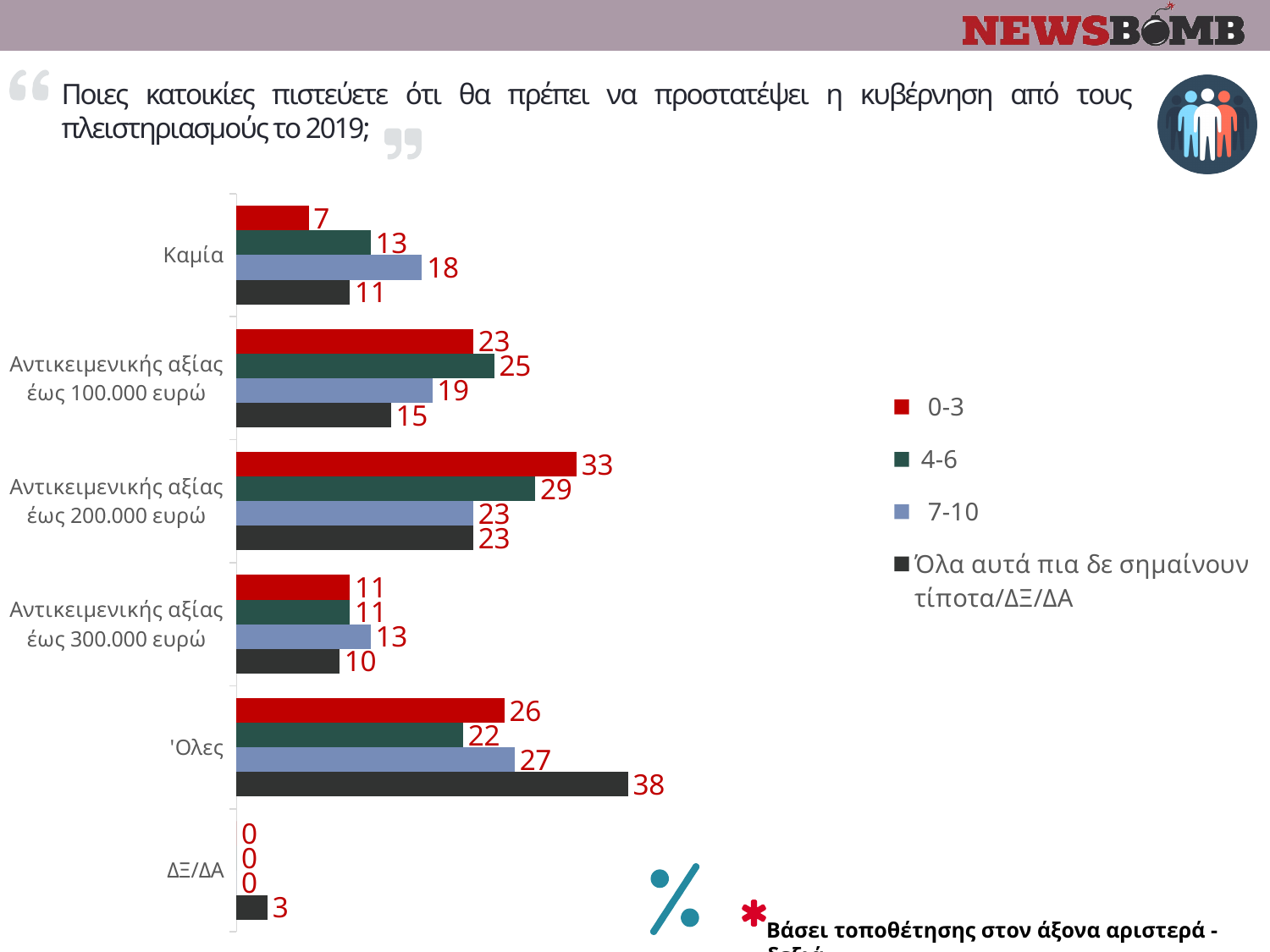
What value does the 0-3 series show for 'Αντικειμενικής αξίας έως 200.000 ευρώ'? 33 For 'Όλες', which series has the larger value: 0-3 or 4-6? 0-3 How many categories are shown on the chart? 6 What value does the 4-6 series show for 'Αντικειμενικής αξίας έως 100.000 ευρώ'? 25 What value does the 'Όλα αυτά πια δε σημαίνουν τίποτα/ΔΞ/ΔΑ' series show for 'Όλες'? 38 What is the difference between the 0-3 value and the 7-10 value for 'Αντικειμενικής αξίας έως 200.000 ευρώ'? 10 What colour represents the 0-3 series in the legend? Red Which category has the lowest value in the 7-10 series? ΔΞ/ΔΑ Which category has the highest value in the 0-3 series? Αντικειμενικής αξίας έως 200.000 ευρώ How many series does the legend list? 4 What value does the 7-10 series show for 'Καμία'? 18 What kind of chart is shown on the slide? Bar chart